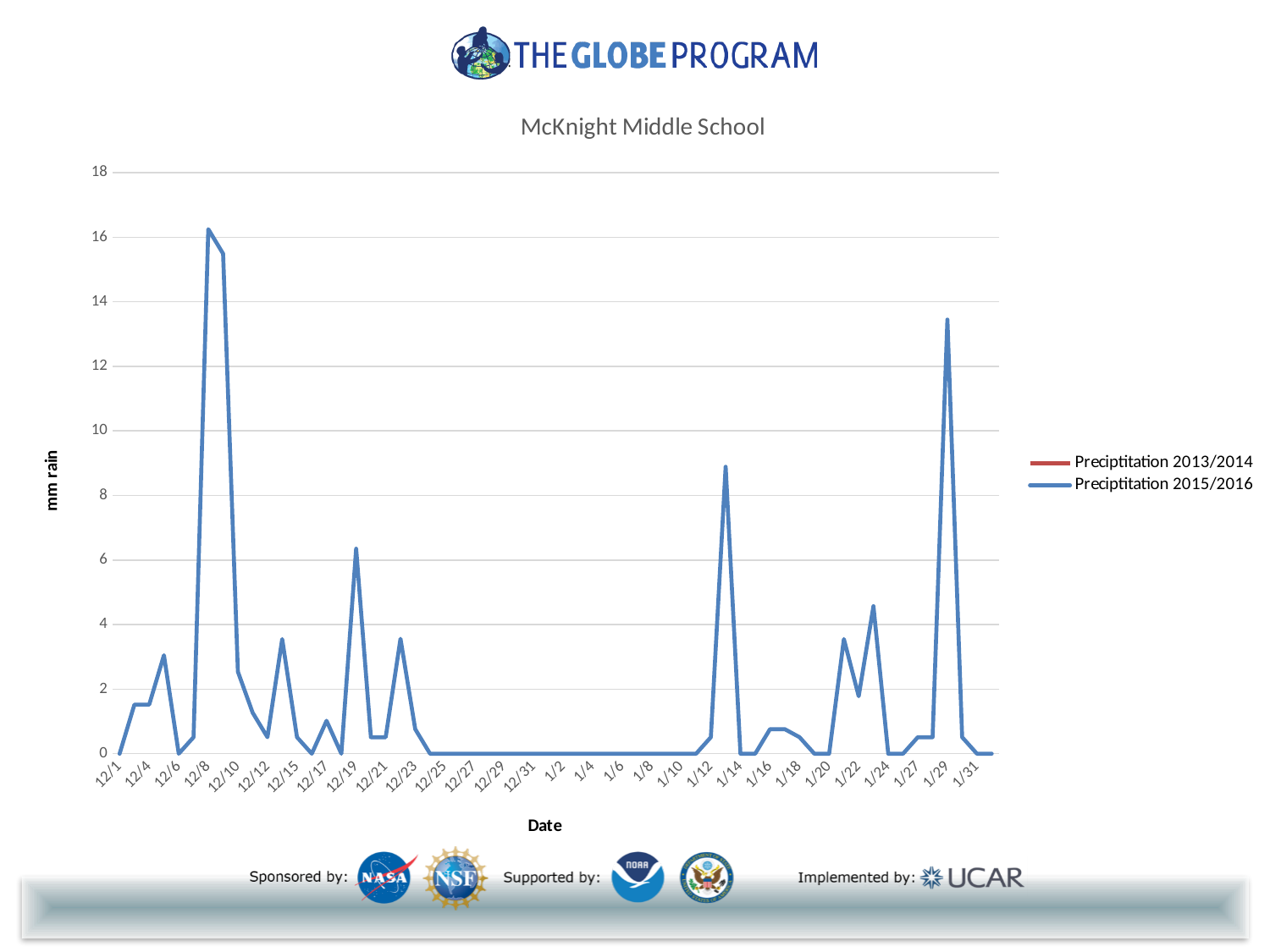
Do the Preciptitation 2015/2016 values rise or fall from 12/8 to 12/12? fall What is the label on the vertical axis of the chart? mm rain Is the Preciptitation 2015/2016 value on 1/13 greater or less than 8? greater How many series does the legend list? 2 What is the Preciptitation 2015/2016 value on 1/2? 0 Which is larger for Preciptitation 2015/2016: the value on 12/8 or the value on 1/29? 12/8 What kind of chart is shown on the slide? line chart Is the Preciptitation 2015/2016 value on 12/23 greater or less than 4? less On which date does the Preciptitation 2015/2016 line reach its highest value? 12/8 Is the Preciptitation 2015/2016 value on 1/29 greater or less than 12? greater What is the title of the chart? McKnight Middle School